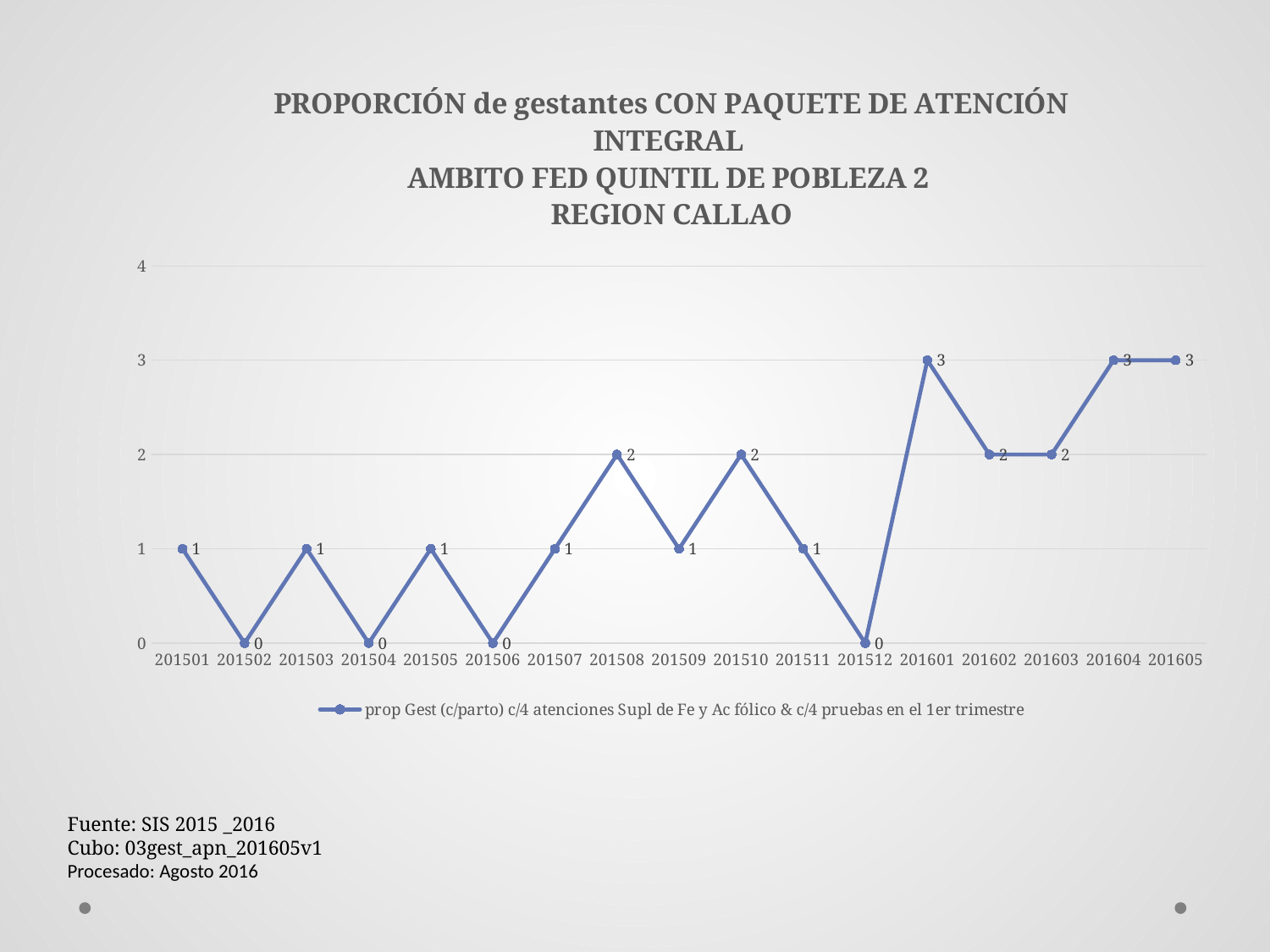
What is the value for 201512? 0 How many series does the legend list? 1 What is the value for 201602? 2 Which is larger, the value for 201510 or the value for 201511? 201510 Which region is named in the chart title? REGION CALLAO What is the value for 201508? 2 Is the value for 201604 greater or less than 2? greater What is the value for 201601? 3 How many data points are plotted on the chart? 17 What is the highest value reached on the chart? 3 What type of chart is shown on the slide? line chart What is the difference between the values for 201601 and 201512? 3